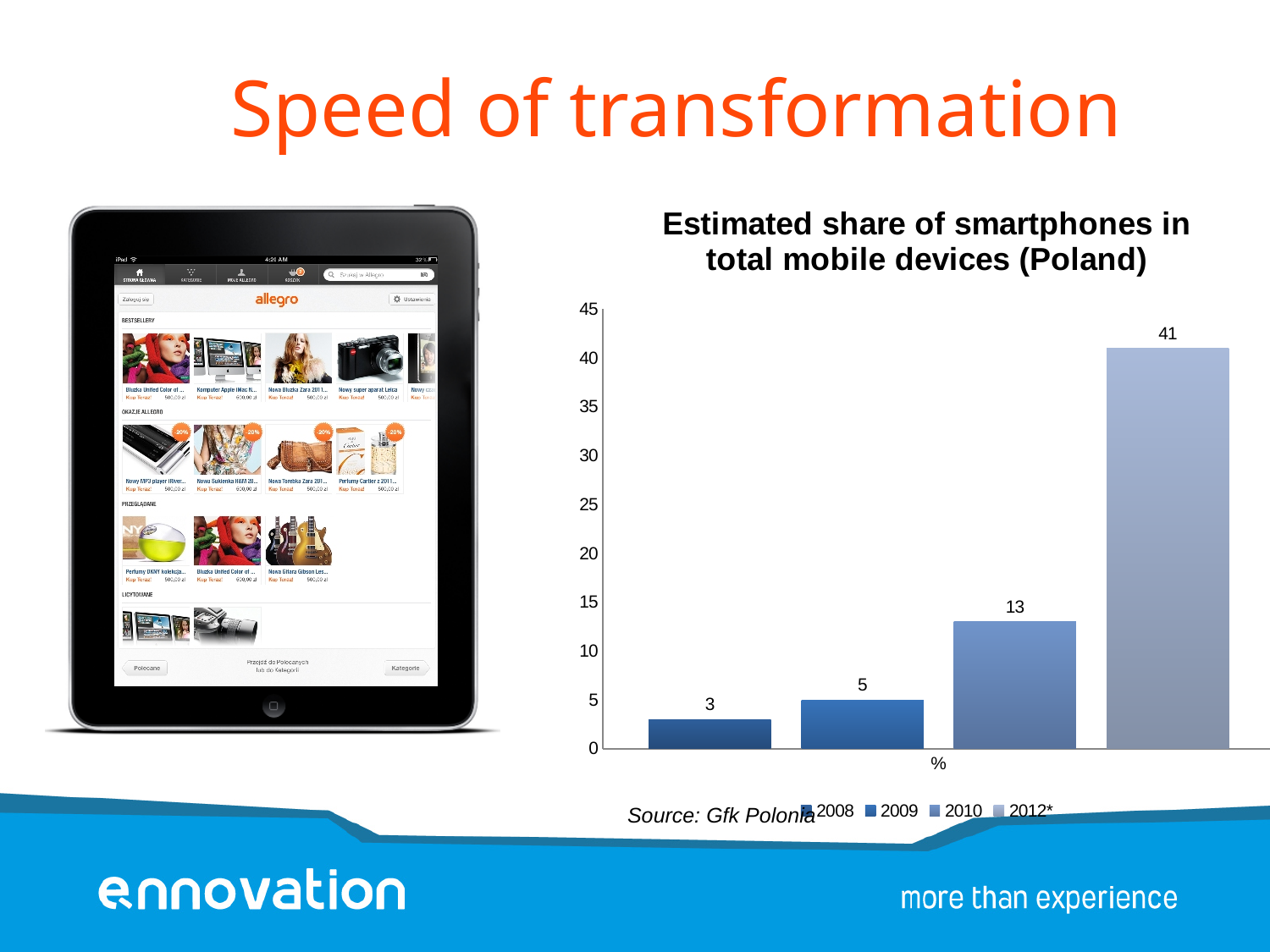
What kind of chart is shown on the slide? bar chart What is the estimated share of smartphones for 2008? 3 Which year has the highest estimated share of smartphones? 2012* Which is larger, the value for 2009 or the value for 2010? 2010 What is the estimated share of smartphones for 2010? 13 How many series does the legend list? 4 What is the difference between the 2009 and 2008 values? 2 What is the difference between the 2012* and 2010 values? 28 What is the title of the chart? Estimated share of smartphones in total mobile devices (Poland) Is the value for 2012* greater or less than 40? greater Which year has the lowest estimated share of smartphones? 2008 What is the estimated share of smartphones for 2012*? 41